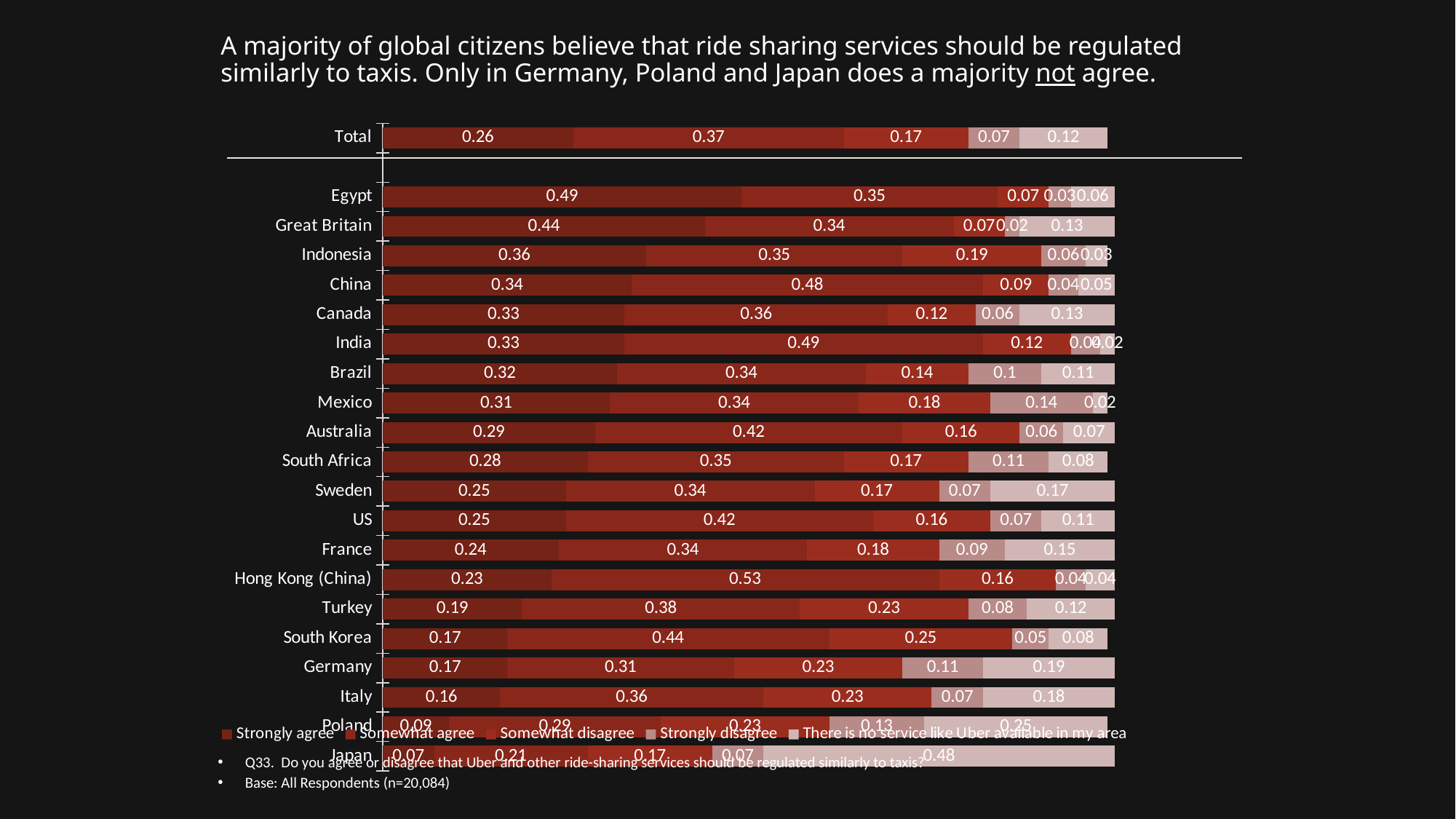
Which country has the lowest Strongly agree value? Japan What is the difference between the Somewhat agree and Strongly agree values in the Total bar? 0.11 Which country has the highest Somewhat agree value? Hong Kong (China) What is the Somewhat agree value for Hong Kong (China)? 0.53 What is the value for Strongly agree for Egypt? 0.49 What kind of chart is shown on the slide? Stacked bar chart What is the value for 'There is no service like Uber available in my area' for Germany? 0.19 How many series does the legend list? 5 Which has a larger Strongly agree value, Canada or Turkey? Canada How many countries are shown in the chart, excluding the Total bar? 20 Which country has the highest Strongly agree value? Egypt What is the Somewhat agree value for the Total bar? 0.37